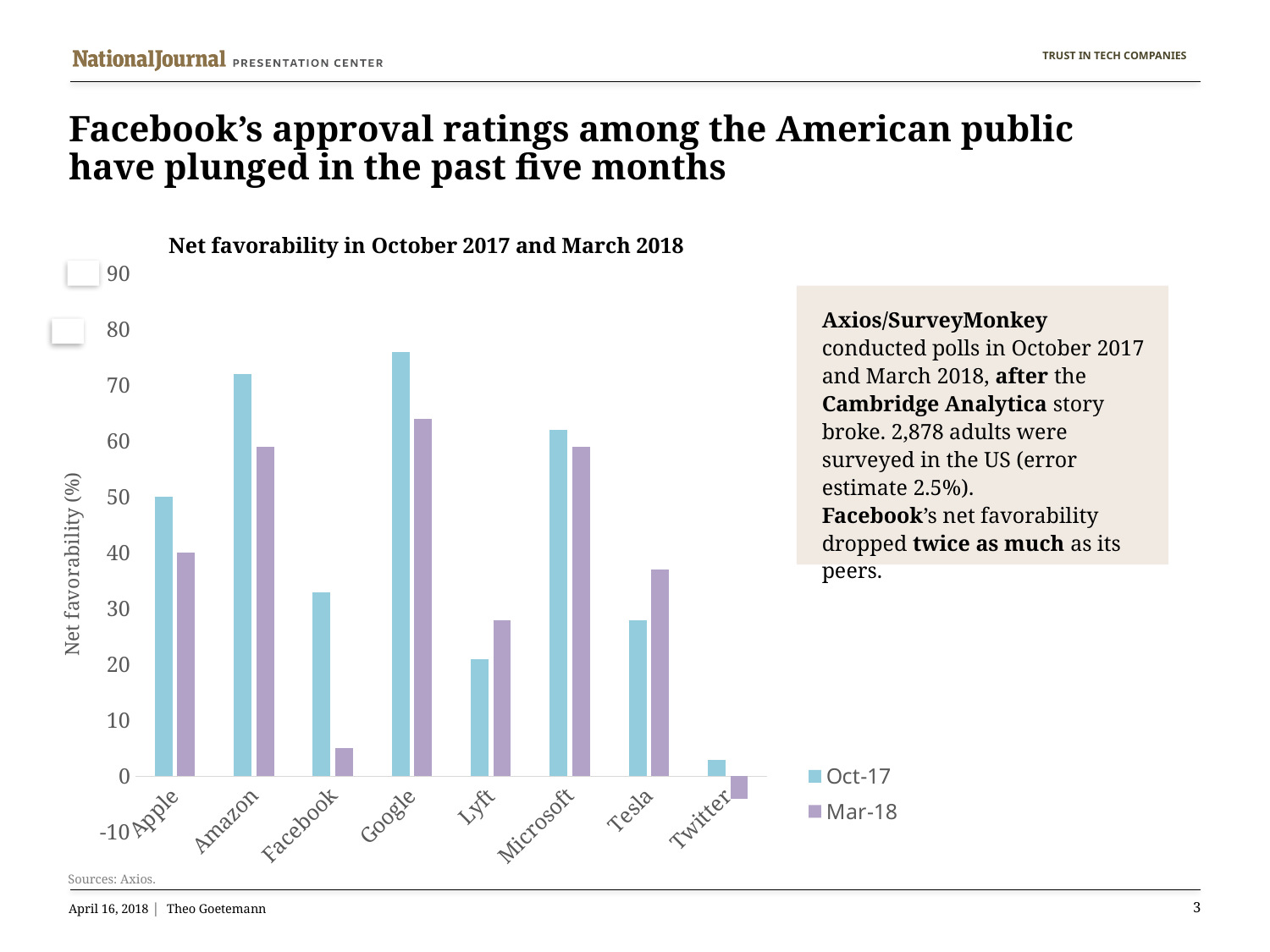
How many companies are shown on the x axis? 8 Is the Oct-17 value for Amazon greater or less than 70? greater What kind of chart is shown on the slide? bar chart What is the title of the chart? Net favorability in October 2017 and March 2018 Is the Mar-18 value for Twitter greater or less than 0? less Which company has the lowest Mar-18 net favorability? Twitter Is the Mar-18 value for Facebook greater or less than 10? less Which is larger for Lyft, the Oct-17 value or the Mar-18 value? Mar-18 How many series does the legend list? 2 Which company has the highest Oct-17 net favorability? Google Which is larger for Facebook, the Oct-17 value or the Mar-18 value? Oct-17 Which company has the highest Mar-18 net favorability? Google